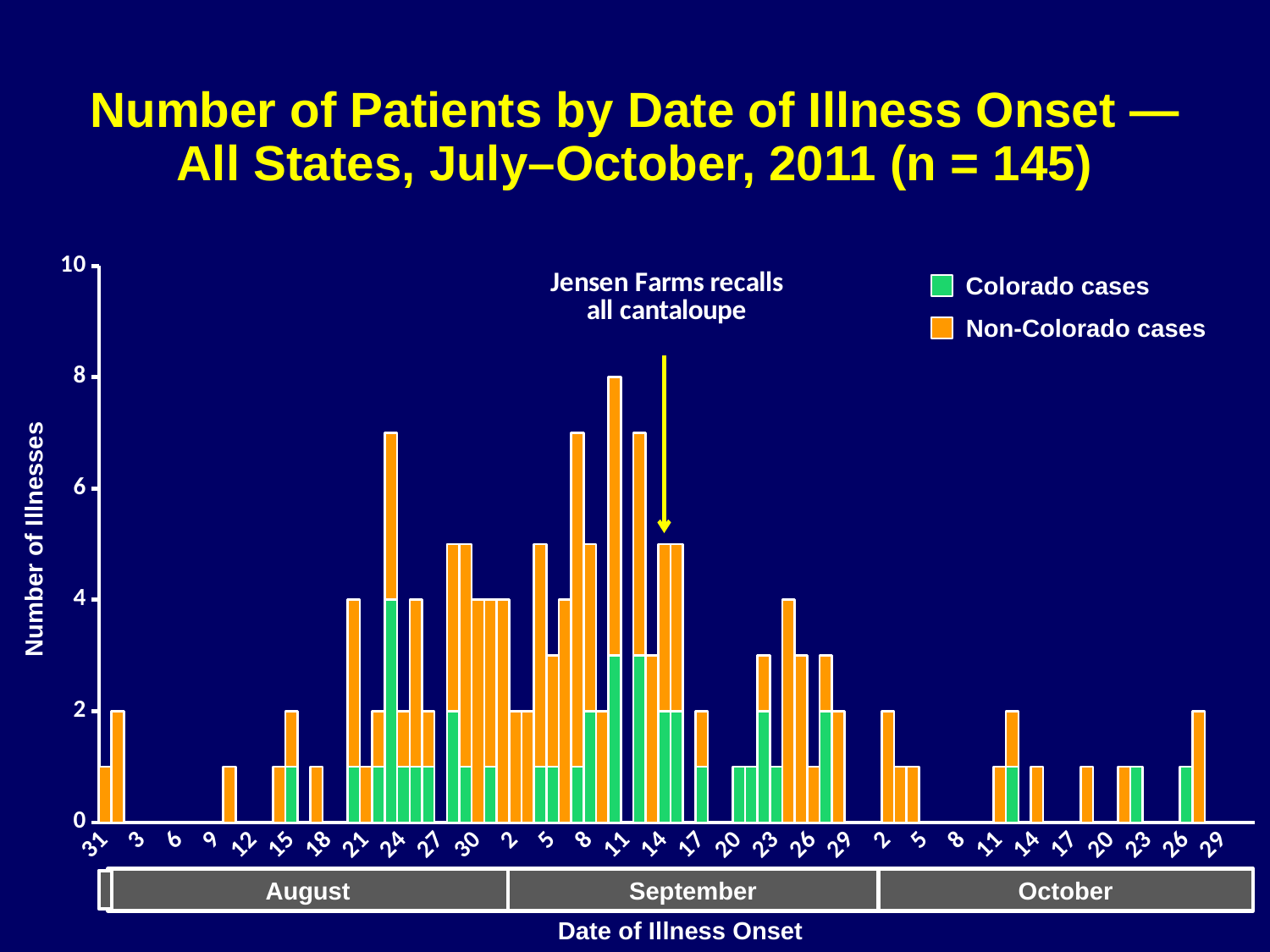
What is the number of illnesses for the tallest bar on the chart? 8 What is the highest value shown on the y axis? 10 What kind of chart is shown on the slide? Stacked bar chart After the peak in mid-September, do the bars generally rise or fall through October? fall Is the value of the tallest bar greater or less than 6? greater In which month does the tallest bar occur? September What are the two series named in the legend? Colorado cases and Non-Colorado cases How many months are labelled along the x axis? 3 What is the total number of patients (n) given in the chart title? 145 How many series does the legend list? 2